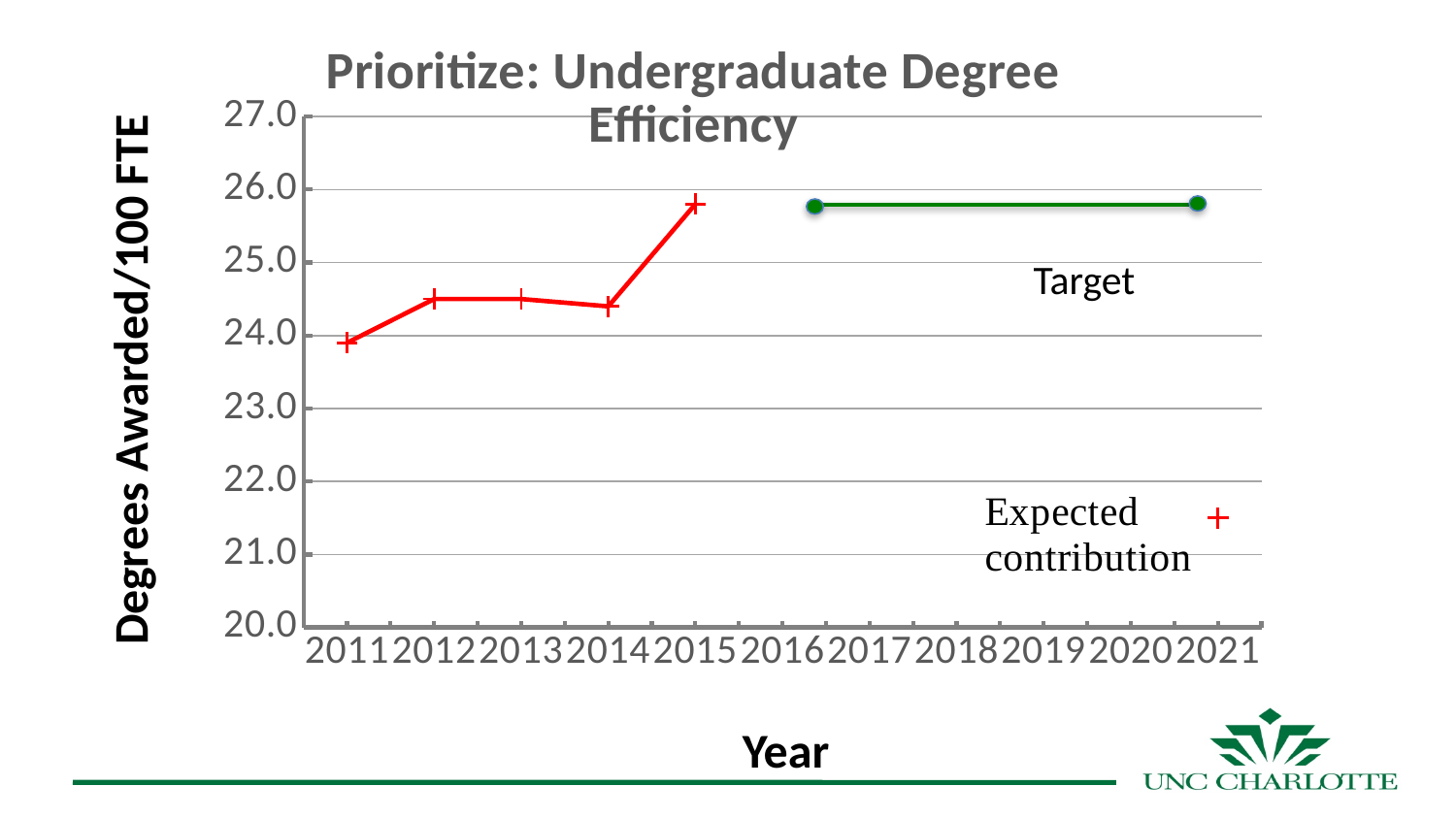
Which is larger, the Expected contribution value for 2013 or for 2011? 2013 How many years are labelled along the x axis? 11 Which year has the lowest value in the red Expected contribution series? 2011 Is the Target line value greater or less than 26.0? less What kind of chart is shown on the slide? line chart Does the Expected contribution series rise or fall overall from 2011 to 2015? rise Is the Expected contribution value for 2011 greater or less than 23.0? greater What is the label on the vertical axis of the chart? Degrees Awarded/100 FTE Is the Expected contribution value for 2015 greater or less than 25.0? greater What is the title of the chart? Prioritize: Undergraduate Degree Efficiency How many data points does the red Expected contribution series have? 5 Which year has the highest value in the red Expected contribution series? 2015